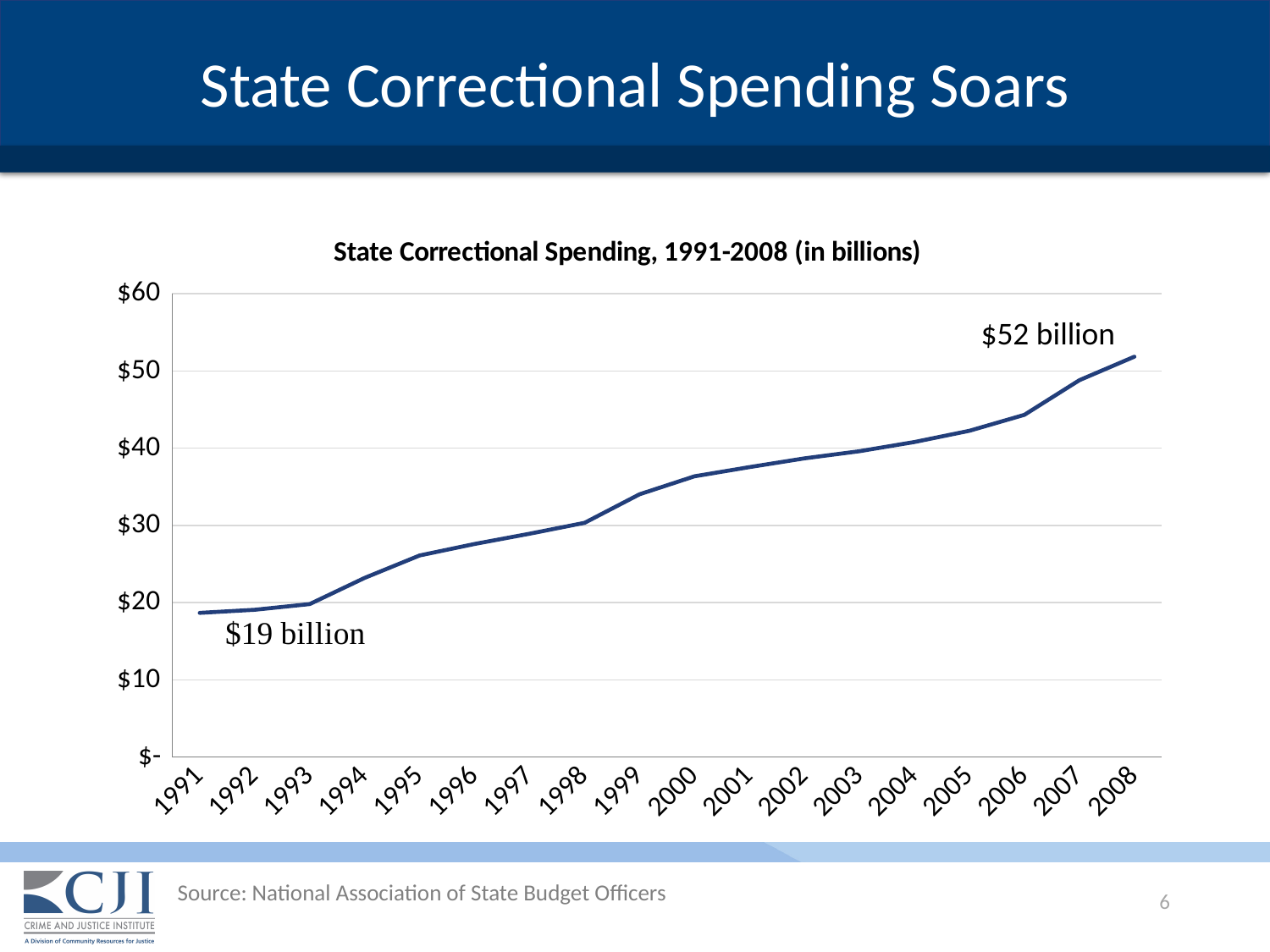
Is the value for 2000 greater or less than $30? greater What type of chart is shown on the slide? Line chart What was state correctional spending in 1991 according to the data label? $19 billion Is the value for 2006 greater or less than $40? greater Is the value for 1995 greater or less than $20? greater Does state correctional spending rise or fall from 1991 to 2008? Rise By how much did state correctional spending increase from 1991 to 2008, based on the labeled values? $33 billion How many years are plotted on the x axis? 18 What was state correctional spending in 2008 according to the data label? $52 billion Which year has the lowest state correctional spending? 1991 Which year has the highest state correctional spending? 2008 What is the title of the chart? State Correctional Spending, 1991-2008 (in billions)